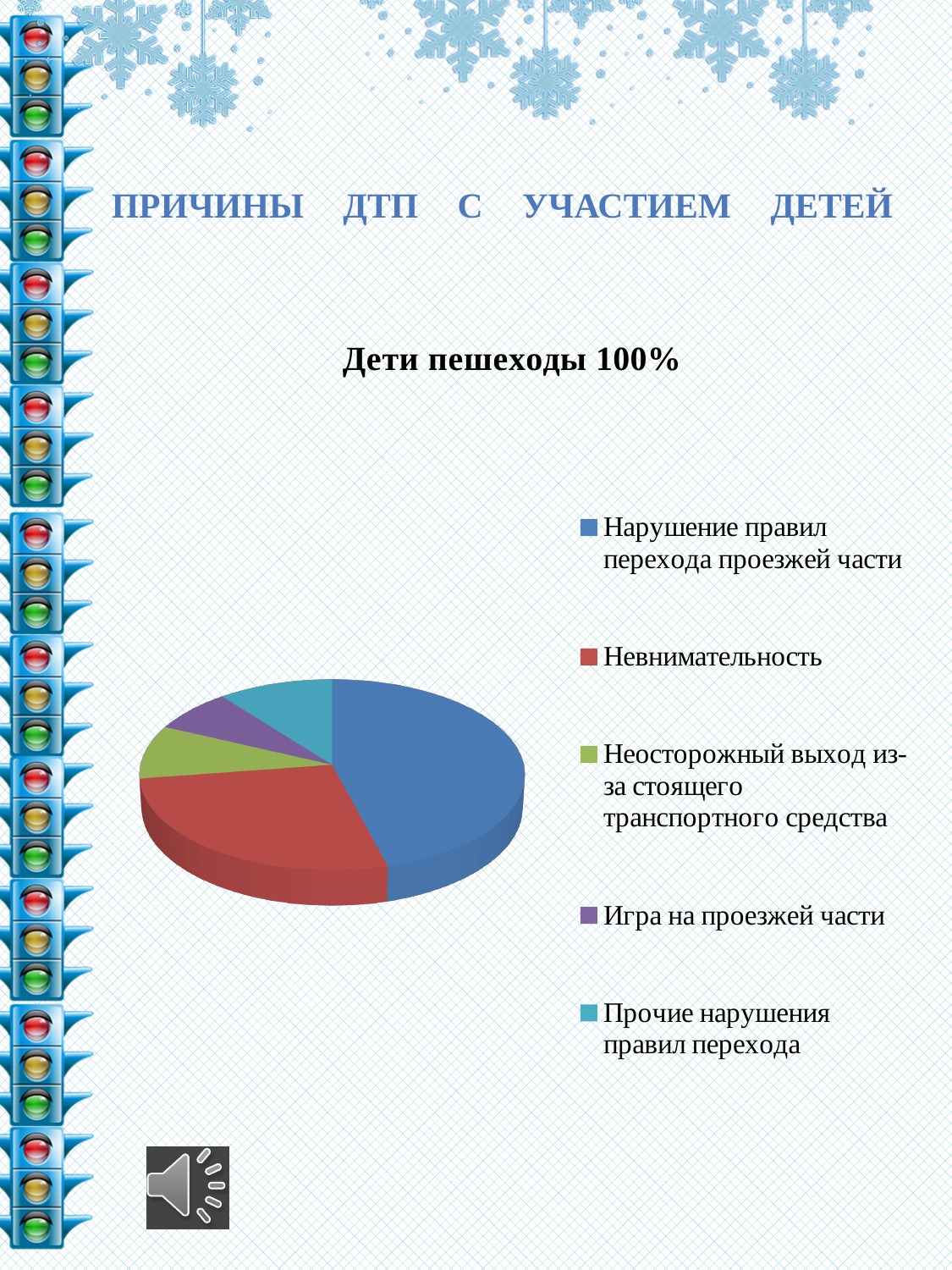
Which slice is larger: Невнимательность or Игра на проезжей части? Невнимательность Which slice is larger: Невнимательность or Неосторожный выход из-за стоящего транспортного средства? Невнимательность How many slices does the pie chart have? 5 Which slice is larger: Нарушение правил перехода проезжей части or Прочие нарушения правил перехода? Нарушение правил перехода проезжей части What kind of chart is shown on the slide? pie chart What is the title of the pie chart? Дети пешеходы 100% Which category has the largest slice of the pie chart? Нарушение правил перехода проезжей части What colour is the slice for Невнимательность in the pie chart? red